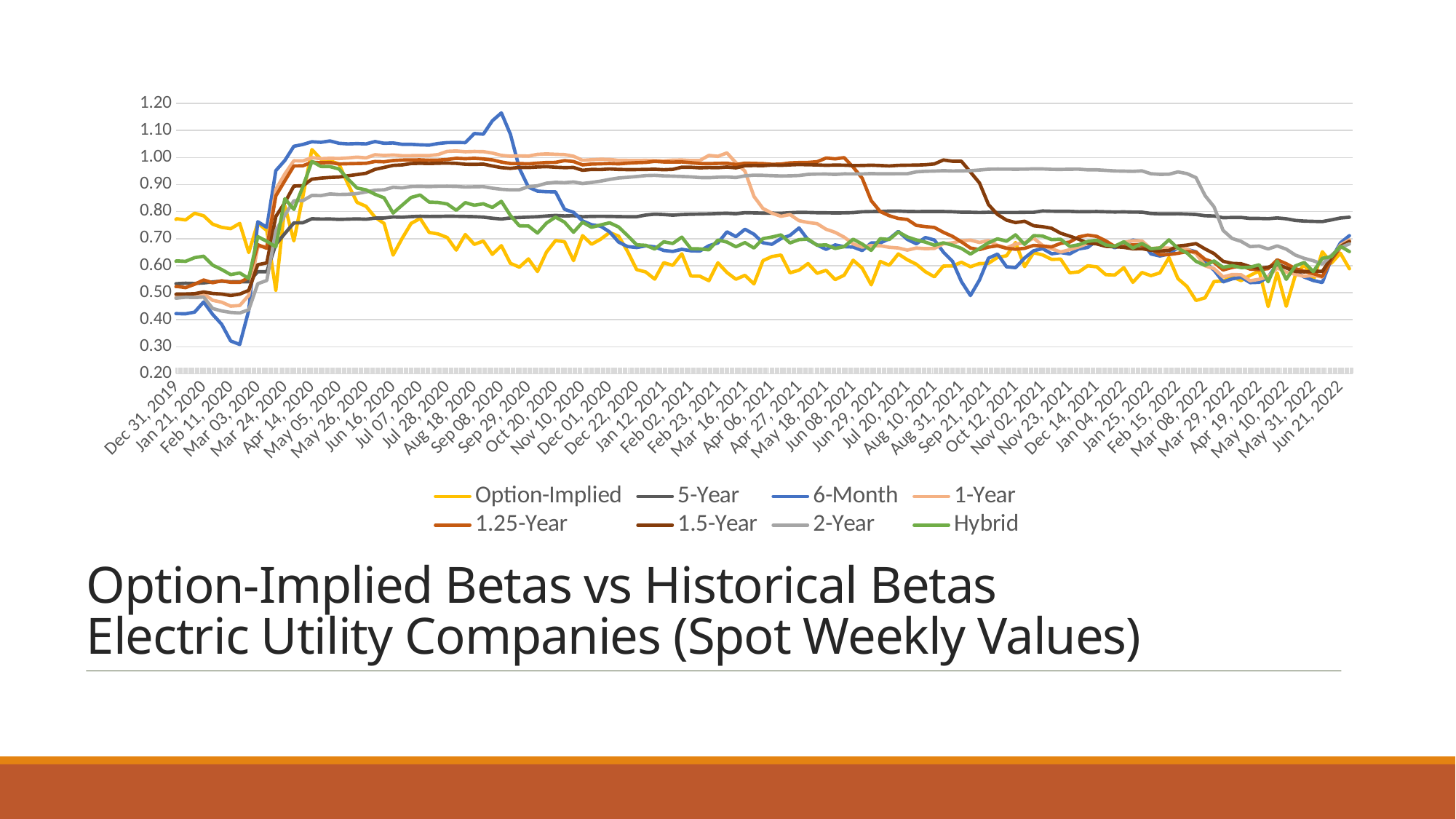
Which series reaches the highest value anywhere on the chart? 6-Month What is the highest value shown on the vertical axis? 1.20 What kind of chart is shown on the slide? line chart Which series reaches the lowest value anywhere on the chart? 6-Month Does the 5-Year series rise or fall between Dec 31, 2019 and Jun 21, 2022? rise Is the value of the 5-Year series at Jun 21, 2022 greater or less than 0.70? greater Is the value of the 6-Month series around Feb 11, 2020 greater or less than 0.40? less How many series does the legend list? 8 Is the value of the Hybrid series at Dec 31, 2019 greater or less than 0.50? greater Does the 6-Month series rise or fall between Sep 08, 2020 and Dec 01, 2020? fall Around Sep 08, 2020, which series has the larger value, 6-Month or 5-Year? 6-Month